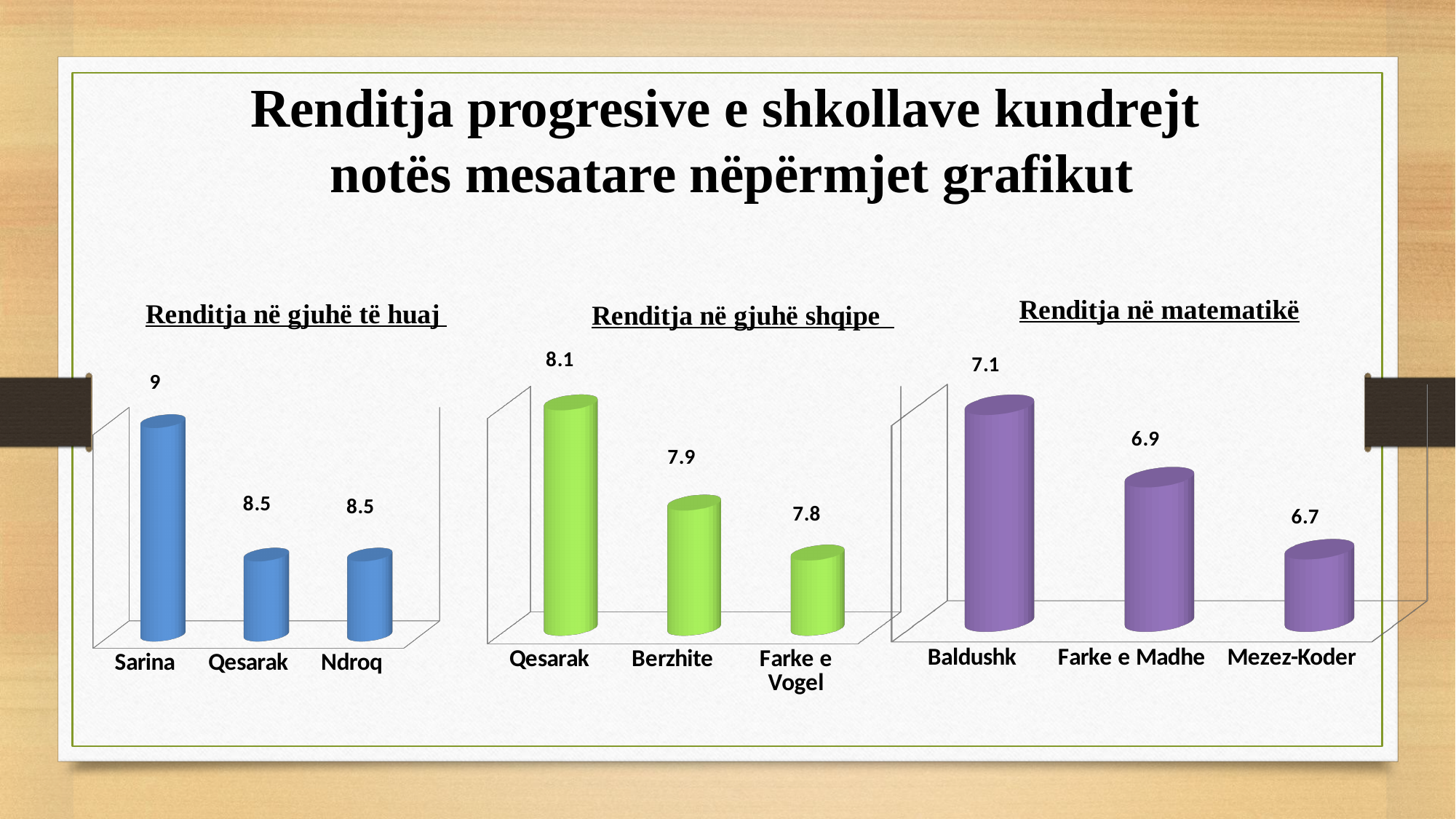
How many categories are shown in the 'Renditja në matematikë' chart? 3 In the 'Renditja në matematikë' chart, which category has the lowest value? Mezez-Koder In the 'Renditja në gjuhë shqipe' chart, do the values rise or fall from left to right? Fall In the 'Renditja në matematikë' chart, what is the value for Mezez-Koder? 6.7 In the 'Renditja në gjuhë të huaj' chart, what is the value for Ndroq? 8.5 In the 'Renditja në gjuhë shqipe' chart, which category has the highest value? Qesarak What kind of chart is the 'Renditja në gjuhë shqipe' chart? Bar chart In the 'Renditja në gjuhë shqipe' chart, which is larger, the value for Berzhite or the value for Farke e Vogel? Berzhite In the 'Renditja në gjuhë të huaj' chart, what is the difference between the values for Sarina and Qesarak? 0.5 In the 'Renditja në gjuhë shqipe' chart, what is the value for Berzhite? 7.9 In the 'Renditja në matematikë' chart, what is the difference between the values for Baldushk and Farke e Madhe? 0.2 In the 'Renditja në gjuhë të huaj' chart, what is the value for Sarina? 9